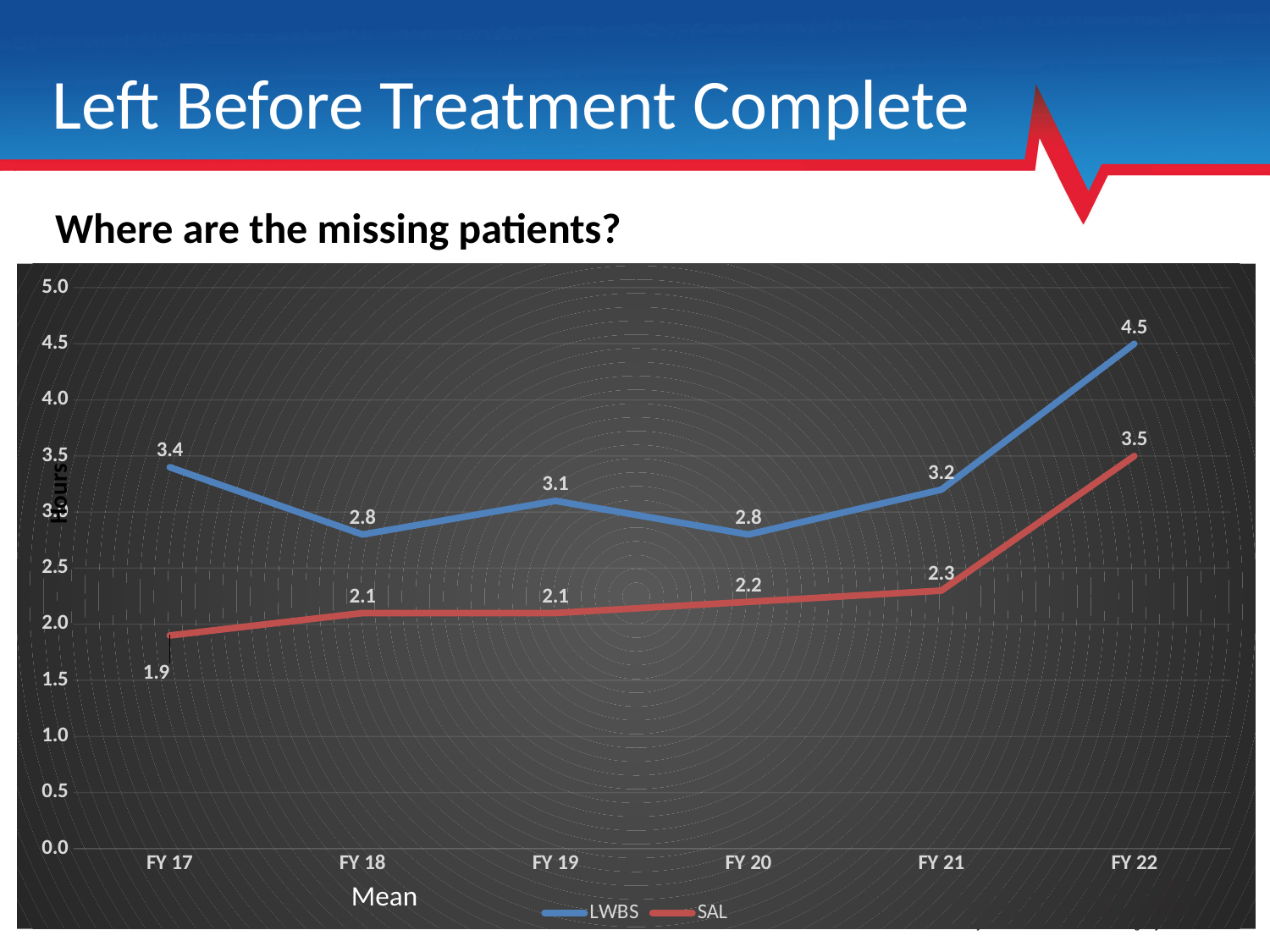
What is the difference between the LWBS and SAL values in FY 22? 1.0 In which fiscal year is the SAL value lowest? FY 17 What is the LWBS value for FY 19? 3.1 What is the SAL value for FY 21? 2.3 In which fiscal year is the LWBS value highest? FY 22 How many series does the legend list? 2 What is the label on the vertical axis? Hours How many fiscal years are shown on the x axis? 6 What is the SAL value for FY 17? 1.9 What is the LWBS value for FY 22? 4.5 Which series has the larger value in FY 20, LWBS or SAL? LWBS What kind of chart is shown on the slide? Line chart